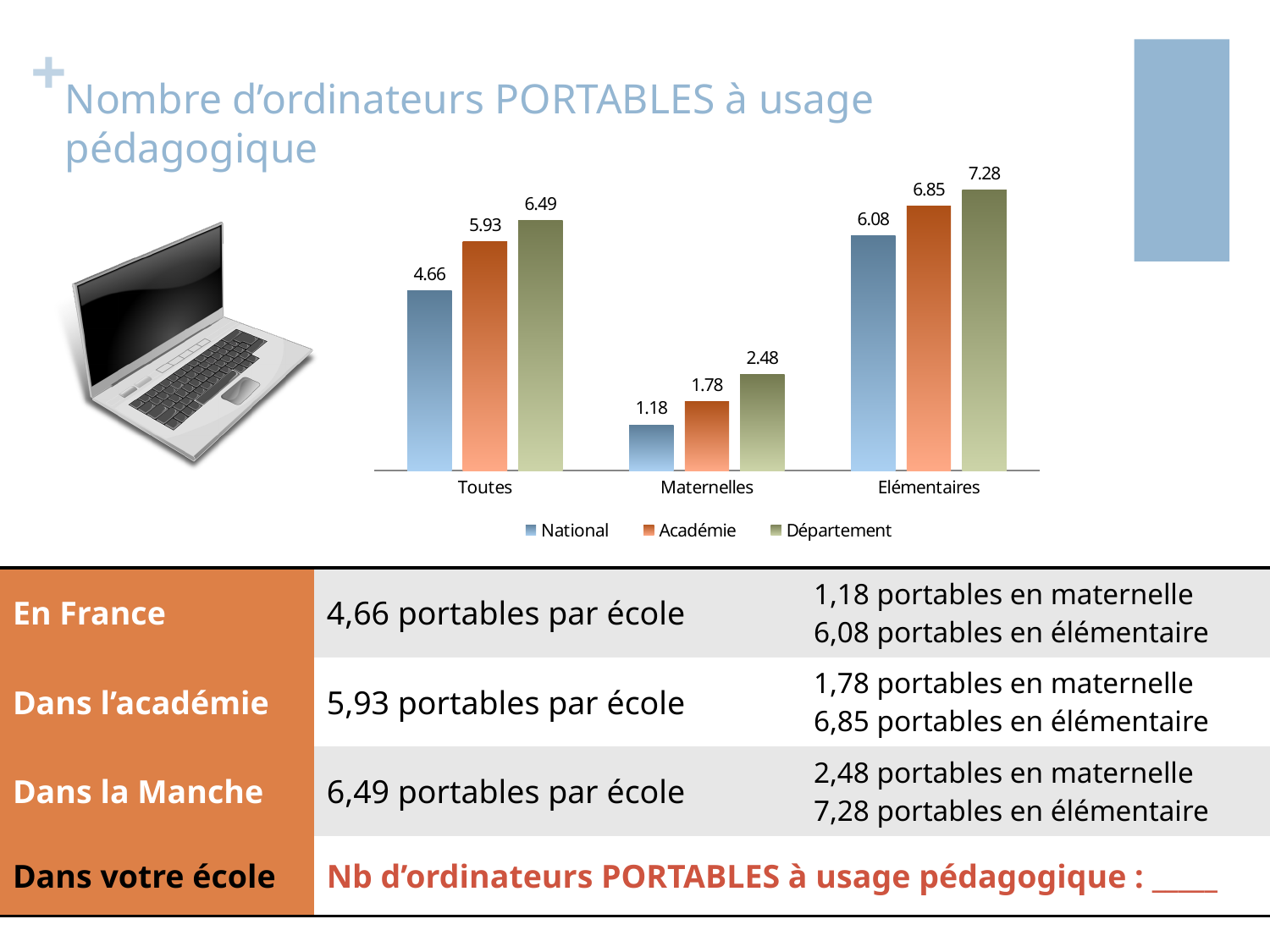
Which category has the lowest National value? Maternelles Which series has the highest value in the Elémentaires category? Département Which is larger: the Académie value for Elémentaires or the Département value for Toutes? Académie value for Elémentaires What kind of chart is shown on the slide? Bar chart What is the value for Académie in the Maternelles category? 1.78 What is the value for National in the Toutes category? 4.66 What is the value for Département in the Elémentaires category? 7.28 What is the difference between the Département and Académie values in the Maternelles category? 0.70 What is the difference between the Département and National values in the Toutes category? 1.83 Which series is shown in orange in the legend? Académie How many categories are shown on the x axis? 3 How many series does the legend list? 3